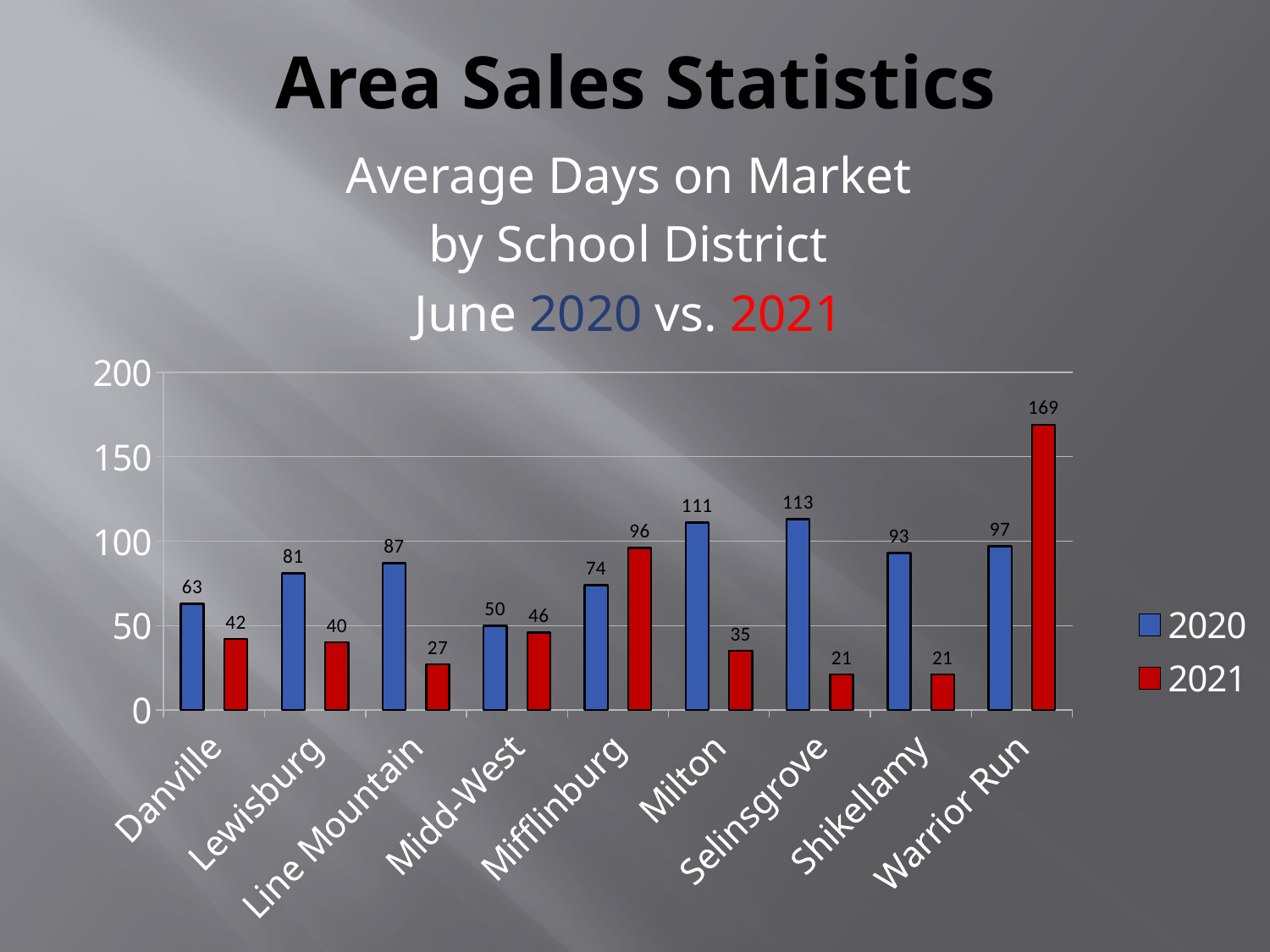
What is the difference between the 2020 and 2021 values for Milton? 76 What colour represents the 2021 series in the chart? Red What kind of chart is shown on the slide? Bar chart How many school districts are shown on the x axis? 9 Is the 2020 value for Selinsgrove greater or less than 100? greater What was the average days on market for Danville in 2020? 63 Which two school districts share the lowest 2021 value of 21? Selinsgrove and Shikellamy How many series does the legend list? 2 What was the average days on market for Warrior Run in 2021? 169 Which school district had the highest average days on market in 2021? Warrior Run Which is larger for Mifflinburg: the 2020 value or the 2021 value? 2021 Which school district had the lowest average days on market in 2020? Midd-West